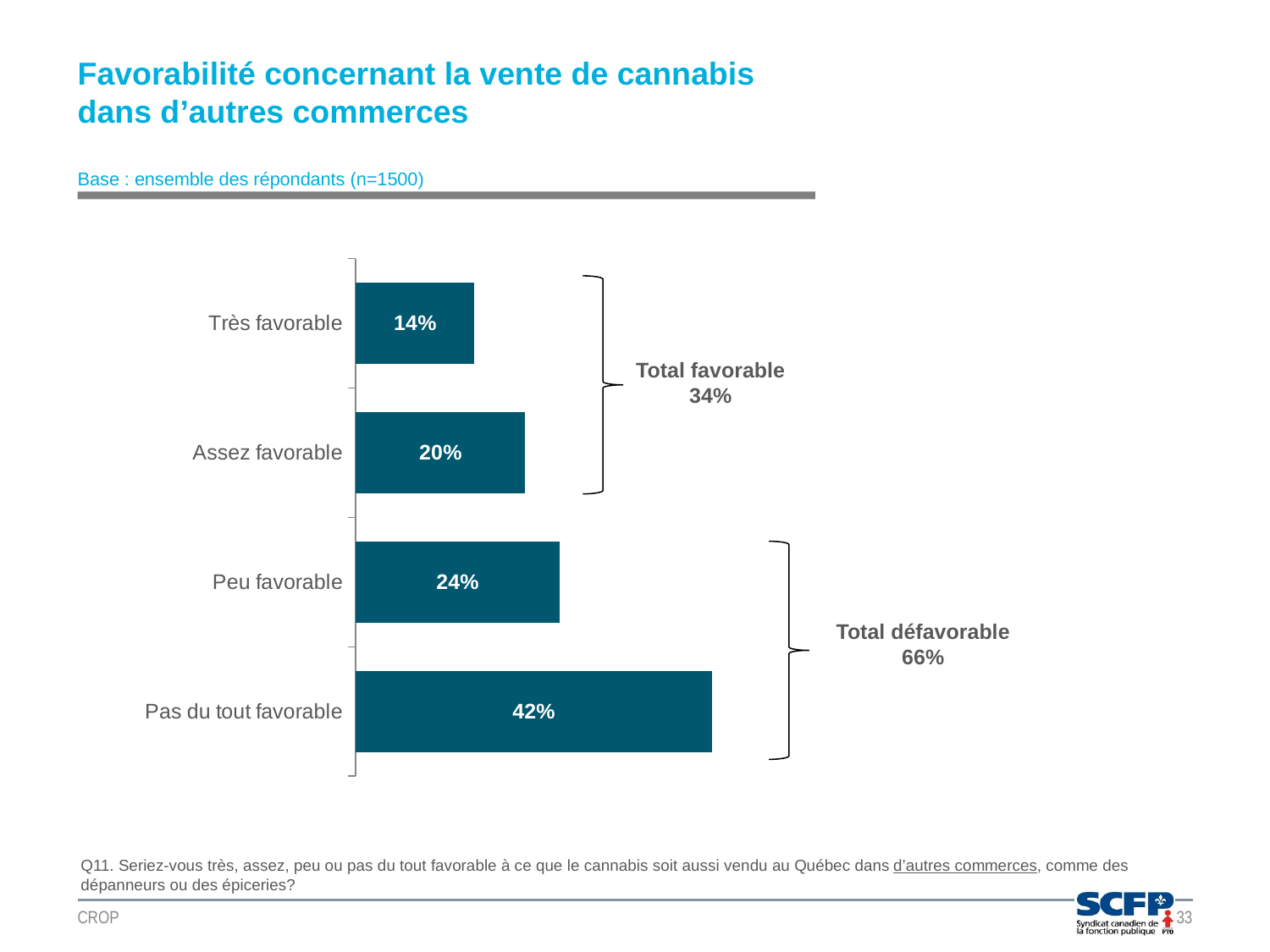
What is the value for "Très favorable"? 14% How many categories are shown in the chart? 4 What kind of chart is shown on the slide? Bar chart What is the value for "Peu favorable"? 24% What is the "Total favorable" percentage shown on the slide? 34% Which category has the highest value? Pas du tout favorable What is the value for "Pas du tout favorable"? 42% Which is larger, the value for "Assez favorable" or the value for "Peu favorable"? Peu favorable What is the value for "Assez favorable"? 20% What is the "Total défavorable" percentage shown on the slide? 66% What is the difference between the values for "Pas du tout favorable" and "Peu favorable"? 18% Which category has the lowest value? Très favorable